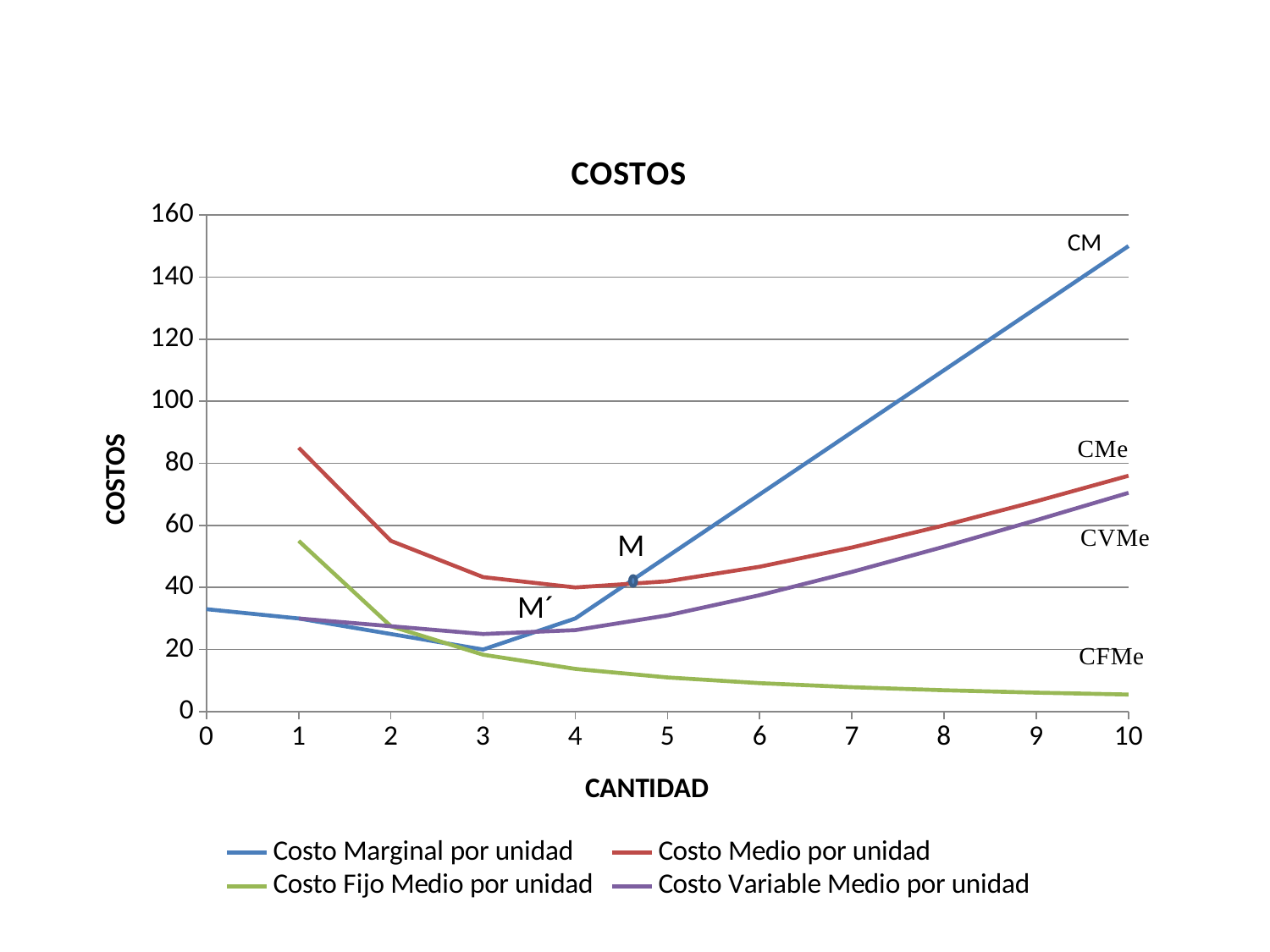
Which series has the highest value at cantidad 1? Costo Medio por unidad Is the value of Costo Fijo Medio por unidad at cantidad 10 greater or less than 20? less At cantidad 10, which is larger: Costo Marginal por unidad or Costo Medio por unidad? Costo Marginal por unidad Which series has the lowest value at cantidad 10? Costo Fijo Medio por unidad What is the label of the horizontal axis? CANTIDAD What is the title of the chart? COSTOS What kind of chart is shown on the slide? line chart Does the Costo Fijo Medio por unidad line rise or fall as cantidad increases? fall Is the value of Costo Marginal por unidad at cantidad 10 greater or less than 140? greater Is the value of Costo Medio por unidad at cantidad 1 greater or less than 80? greater How many series does the legend list? 4